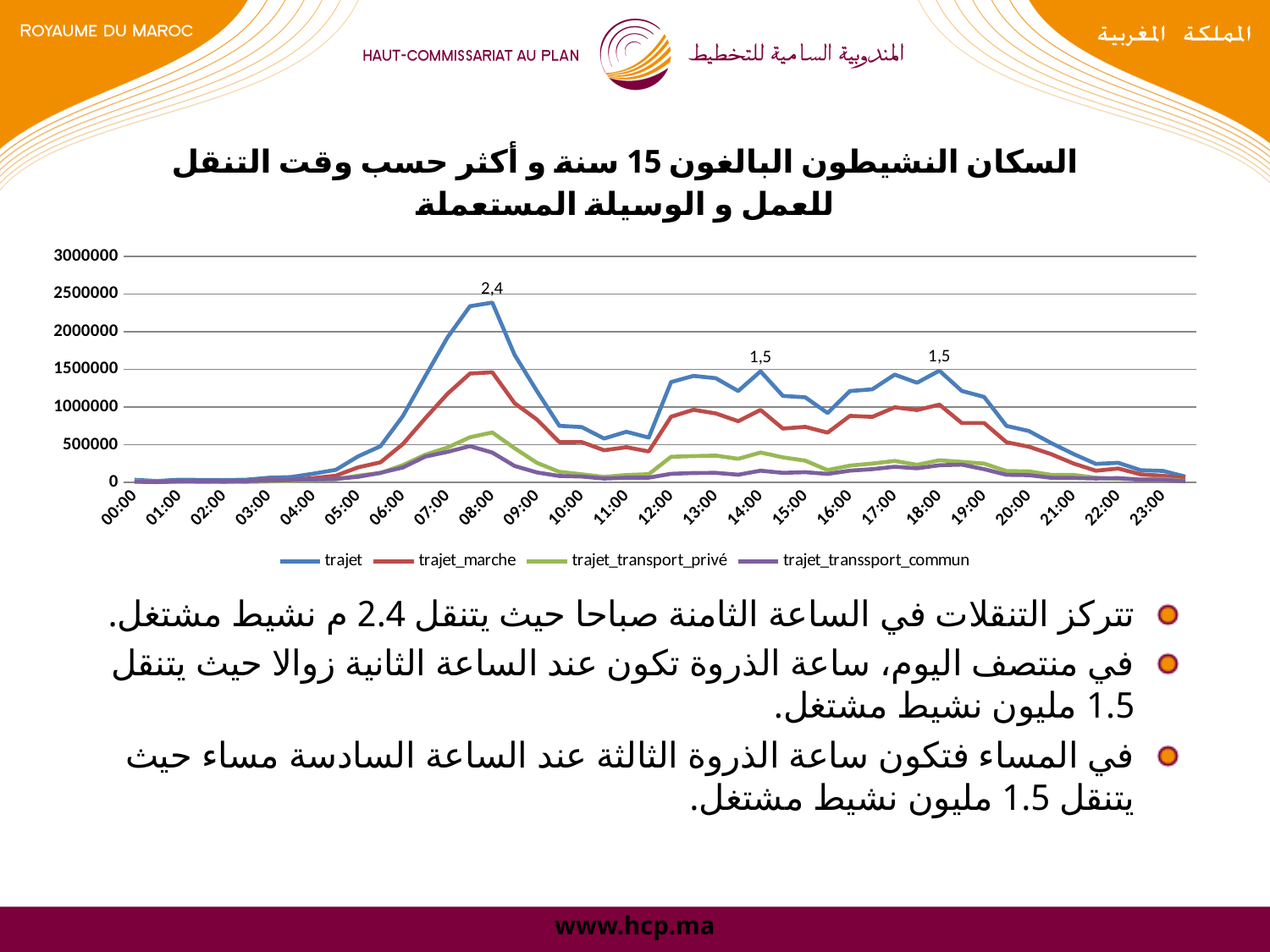
What data label is shown at the 08:00 peak of the trajet series? 2,4 Which series has the highest value at 08:00? trajet Does the trajet series rise or fall between 08:00 and 10:00? fall Is the value of the trajet series at 02:00 greater or less than 500000? less Is the value of the trajet series at 08:00 greater or less than 2000000? greater At 08:00, which is larger: trajet_marche or trajet_transport_privé? trajet_marche Which series has the lowest value at 13:00? trajet_transsport_commun What data label is shown at the 18:00 peak of the trajet series? 1,5 How many series does the legend list? 4 What data label is shown at the 14:00 peak of the trajet series? 1,5 Is the value of the trajet_marche series at 08:00 greater or less than 1000000? greater What kind of chart is shown on the slide? line chart